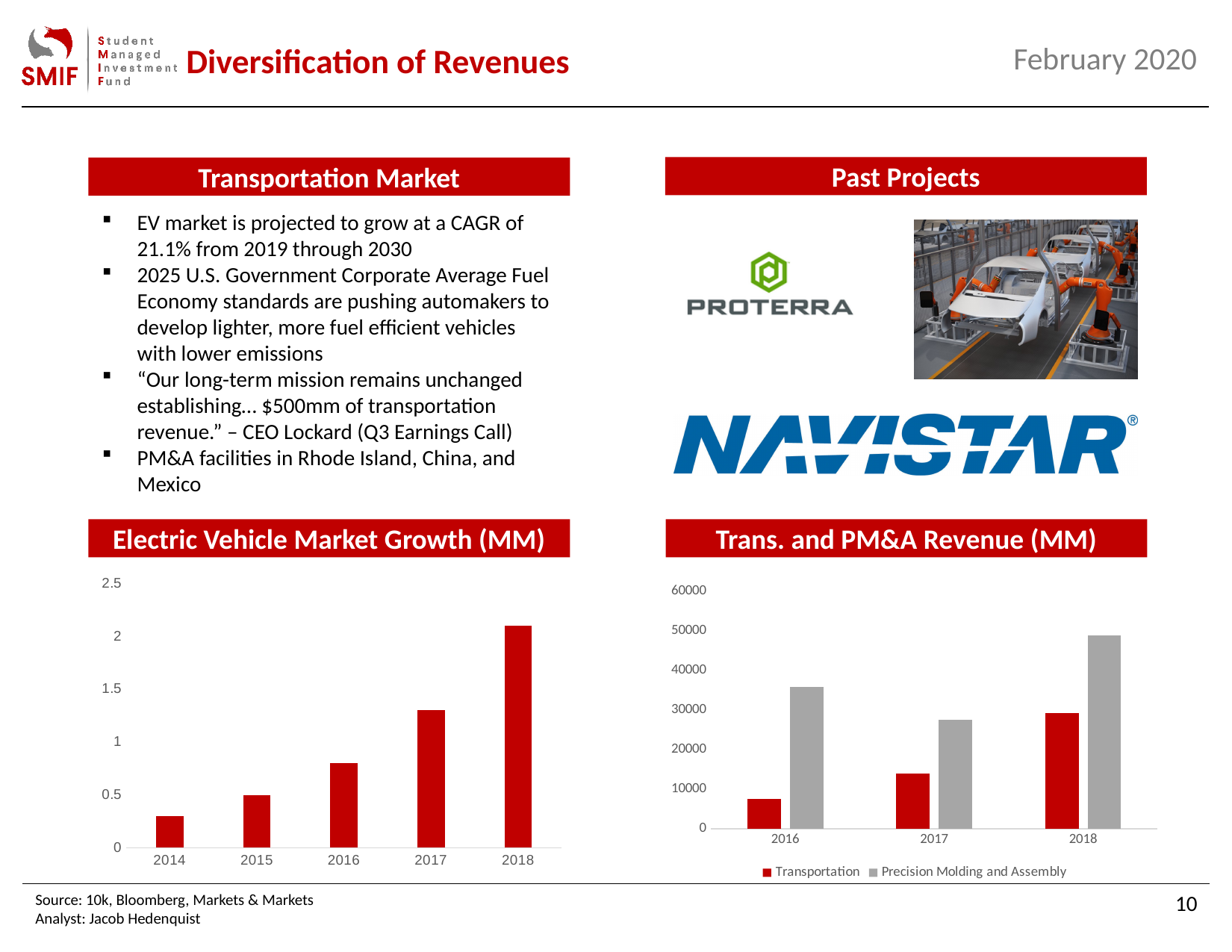
In the Trans. and PM&A Revenue (MM) chart, is the Transportation value for 2016 greater or less than 10000? less In the Trans. and PM&A Revenue (MM) chart, in which year is the Precision Molding and Assembly value highest? 2018 In the Electric Vehicle Market Growth (MM) chart, what type of chart is shown? bar chart In the Trans. and PM&A Revenue (MM) chart, how many series does the legend list? 2 In the Trans. and PM&A Revenue (MM) chart, which is larger in 2017: Transportation or Precision Molding and Assembly? Precision Molding and Assembly In the Electric Vehicle Market Growth (MM) chart, is the value for 2016 greater or less than 1? less In the Electric Vehicle Market Growth (MM) chart, how many years are plotted on the x axis? 5 In the Electric Vehicle Market Growth (MM) chart, which year has the lowest value? 2014 In the Electric Vehicle Market Growth (MM) chart, do the values rise or fall from 2014 to 2018? rise In the Trans. and PM&A Revenue (MM) chart, which series is shown in gray? Precision Molding and Assembly In the Electric Vehicle Market Growth (MM) chart, which year has the highest value? 2018 In the Electric Vehicle Market Growth (MM) chart, is the value for 2018 greater or less than 2? greater